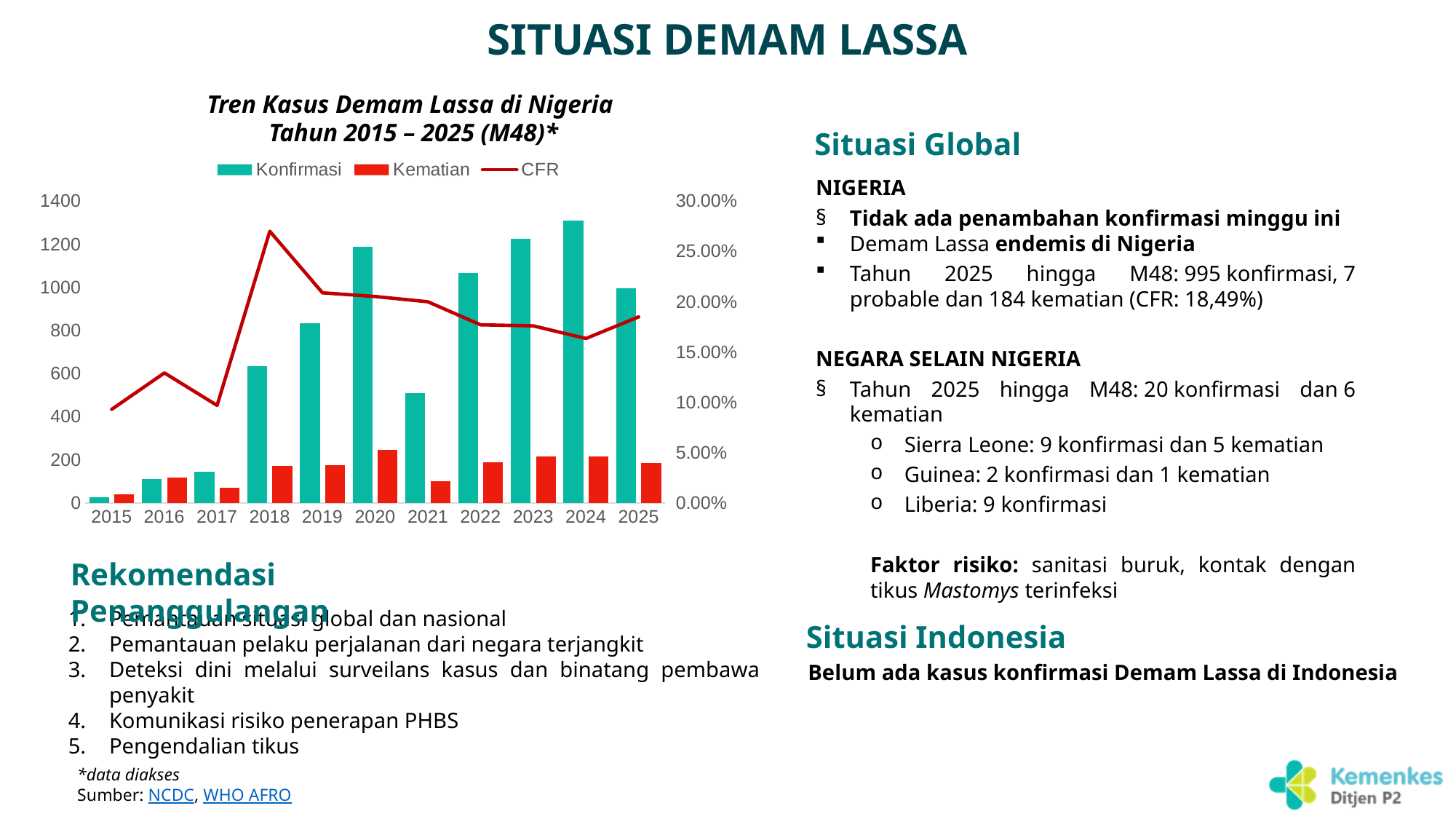
Do the Konfirmasi values rise or fall from 2015 to 2020? rise How many years are shown on the x axis of the chart? 11 In which year is the Kematian bar the highest? 2020 How many series does the legend of the chart 'Tren Kasus Demam Lassa di Nigeria' list? 3 Is the Konfirmasi value for 2020 greater or less than 1000? greater In which year does the CFR line reach its peak? 2018 In which year is the Konfirmasi bar the lowest? 2015 In which year is the Konfirmasi bar the highest? 2024 Is the Konfirmasi value for 2021 greater or less than 600? less What kind of chart is used to show the Lassa fever trend in Nigeria? Bar chart with a line (combination chart) Which year has the larger Konfirmasi value, 2019 or 2021? 2019 Is the CFR value for 2018 greater or less than 25.00%? greater